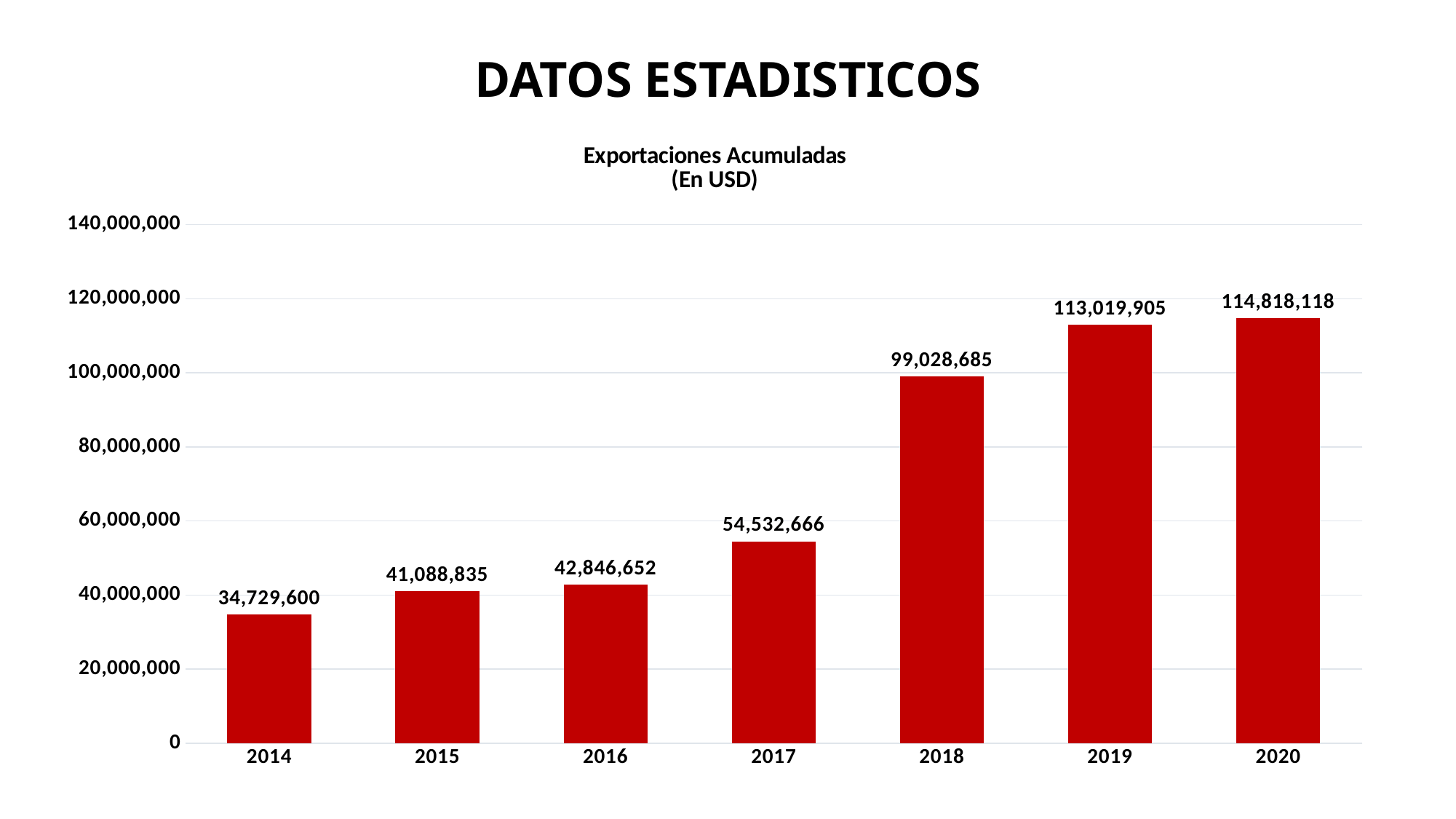
What is the difference between the 2018 and 2017 values in the Exportaciones Acumuladas chart? 44,496,019 Is the value for 2019 in the Exportaciones Acumuladas chart greater or less than 100,000,000? greater Which year has the highest value in the Exportaciones Acumuladas chart? 2020 Do the values in the Exportaciones Acumuladas chart rise or fall from 2014 to 2020? Rise What is the difference between the 2015 and 2014 values in the Exportaciones Acumuladas chart? 6,359,235 Which year has the lowest value in the Exportaciones Acumuladas chart? 2014 What is the value for 2020 in the Exportaciones Acumuladas chart? 114,818,118 How many years are shown in the Exportaciones Acumuladas chart? 7 What is the value for 2014 in the Exportaciones Acumuladas chart? 34,729,600 Which is larger in the Exportaciones Acumuladas chart, the value for 2017 or the value for 2018? 2018 What is the value for 2018 in the Exportaciones Acumuladas chart? 99,028,685 What kind of chart is the Exportaciones Acumuladas chart? Bar chart